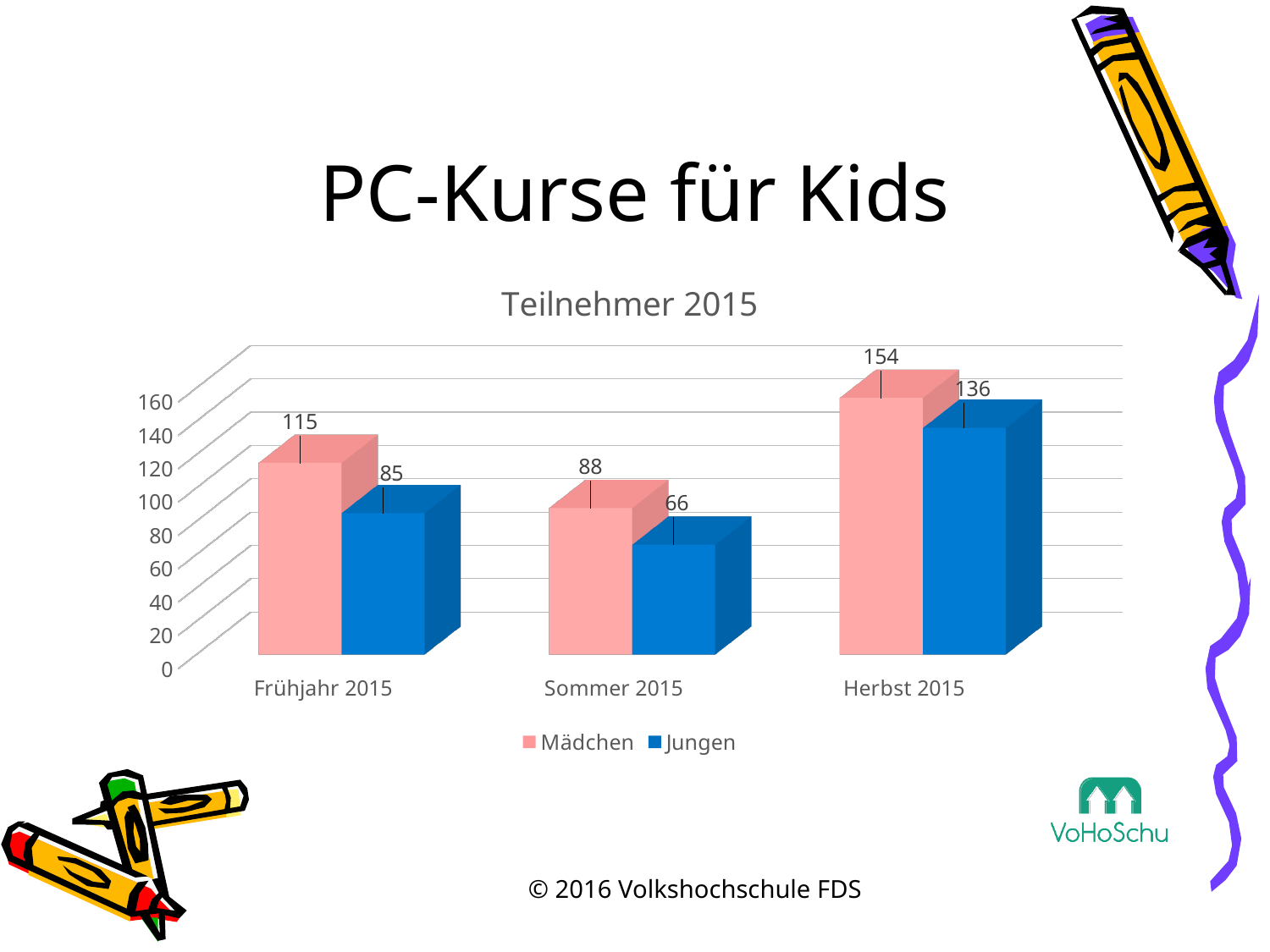
What is the difference between Mädchen in Herbst 2015 and Mädchen in Sommer 2015? 66 What is the value for Mädchen in Frühjahr 2015? 115 What kind of chart is shown on the slide? Bar chart What is the title of the chart? Teilnehmer 2015 Which category has the highest value for Mädchen? Herbst 2015 What is the value for Jungen in Sommer 2015? 66 What is the difference between Mädchen and Jungen in Frühjahr 2015? 30 Which is larger in Herbst 2015, Mädchen or Jungen? Mädchen How many categories are shown on the x axis? 3 Which category has the lowest value for Jungen? Sommer 2015 How many series does the legend list? 2 What is the value for Jungen in Herbst 2015? 136